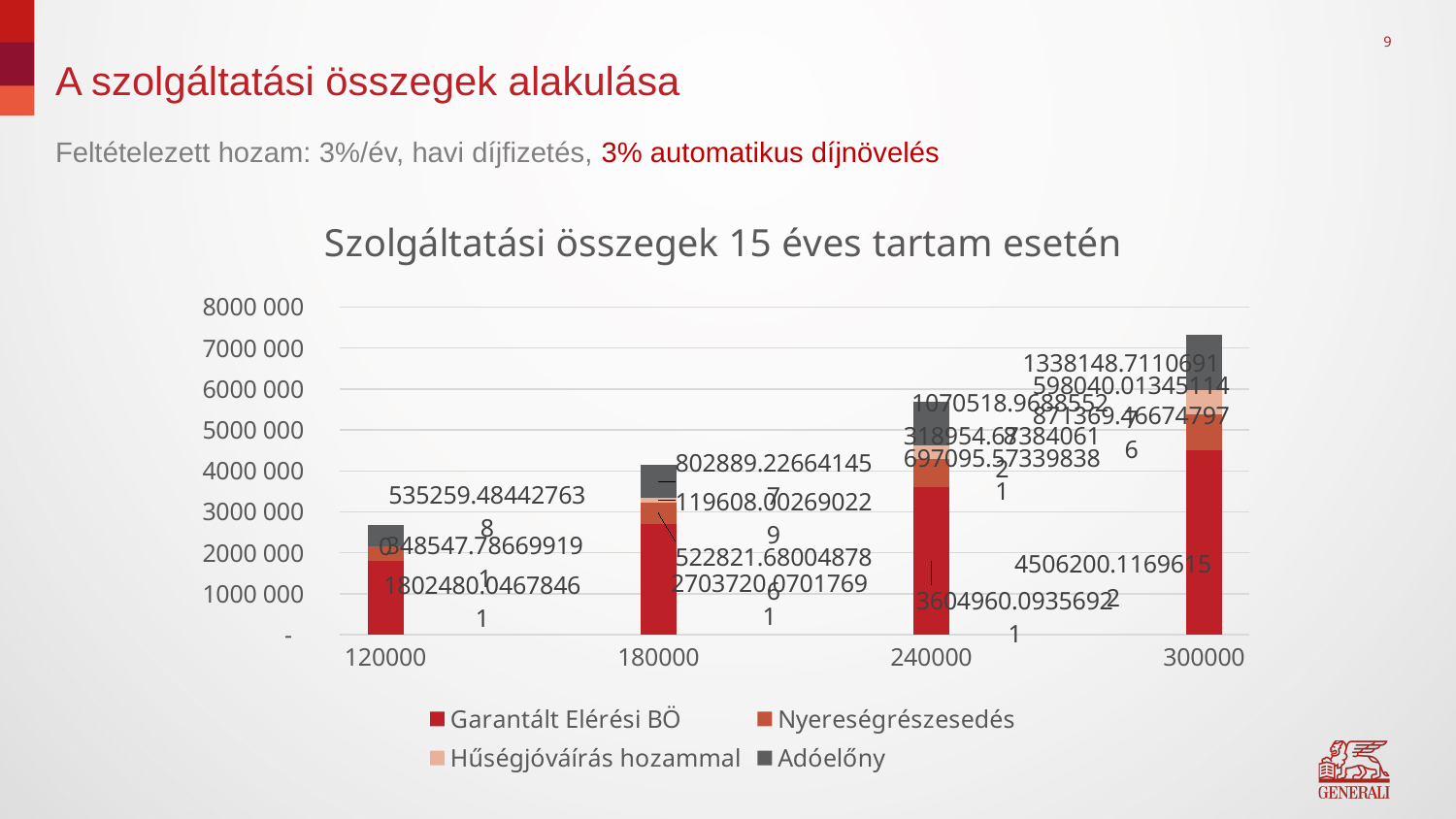
How many series does the chart legend list? 4 Which category has the tallest stacked bar? 300000 Is the total stacked bar for 300000 greater or less than 7000000? greater What is the title of the chart? Szolgáltatási összegek 15 éves tartam esetén What kind of chart is shown on the slide? Stacked bar chart Is the Garantált Elérési BÖ value for 300000 greater or less than 4000000? greater Do the total bar heights rise or fall as the x-axis values increase from 120000 to 300000? Rise Is the total stacked bar for 120000 greater or less than 3000000? less How many categories are shown on the x axis of the chart? 4 Which is larger, the total stacked bar for 180000 or for 240000? 240000 Which series is shown at the bottom of each stacked bar? Garantált Elérési BÖ Which category has the shortest stacked bar? 120000